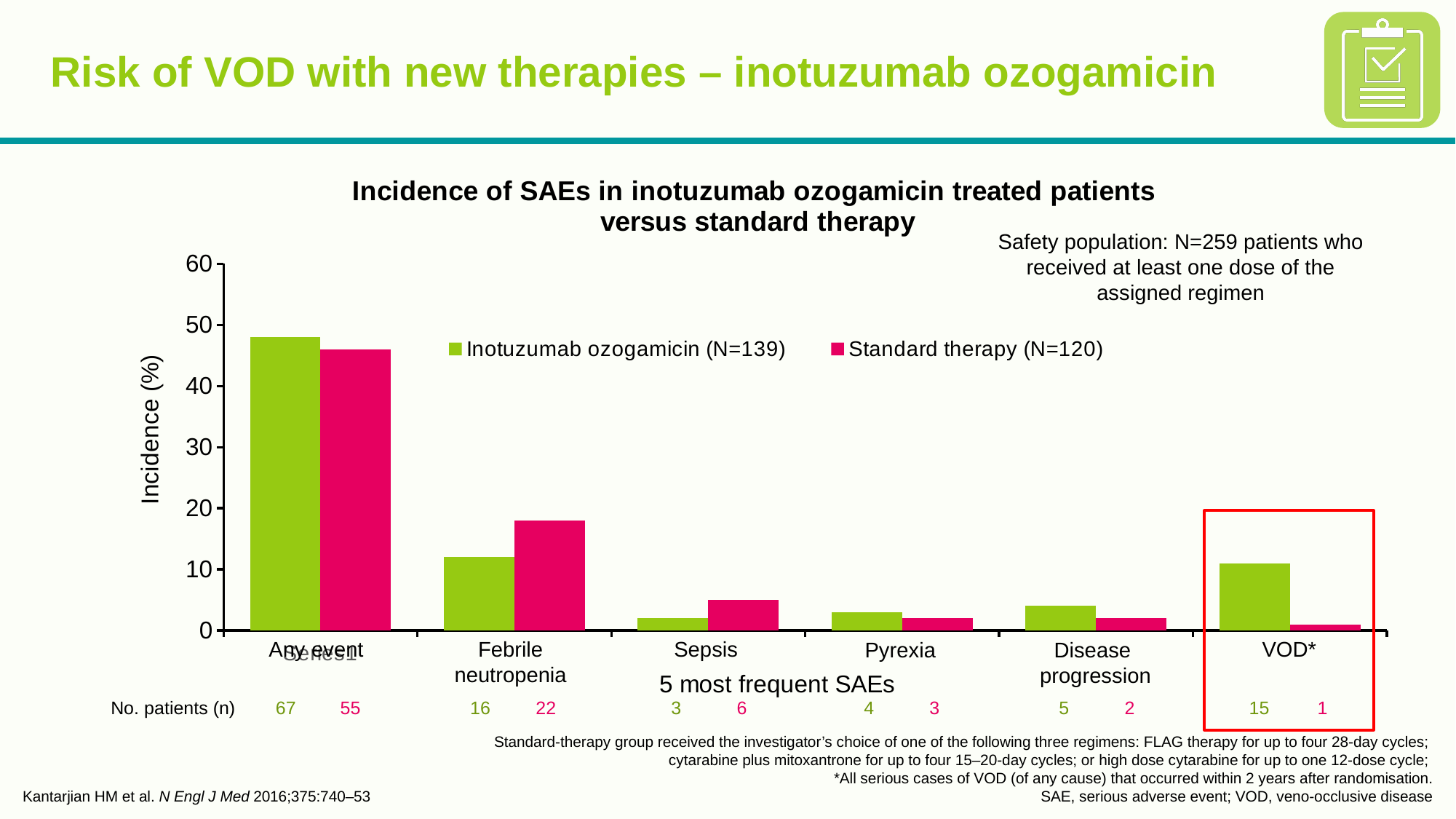
How many patients in the inotuzumab ozogamicin group had VOD*? 15 Which category has the highest incidence for inotuzumab ozogamicin? Any event How many series does the legend list? 2 How many SAE categories are shown along the x axis? 6 For VOD*, which group has the higher incidence: inotuzumab ozogamicin or standard therapy? Inotuzumab ozogamicin Is the incidence of any event for inotuzumab ozogamicin greater or less than 40%? greater For febrile neutropenia, which group has the higher incidence: inotuzumab ozogamicin or standard therapy? Standard therapy Is the incidence of febrile neutropenia for standard therapy greater or less than 10%? greater What kind of chart is shown on the slide? bar chart How many patients in the standard therapy group had febrile neutropenia? 22 Is the incidence of sepsis for standard therapy greater or less than 10%? less What is the label of the y axis? Incidence (%)